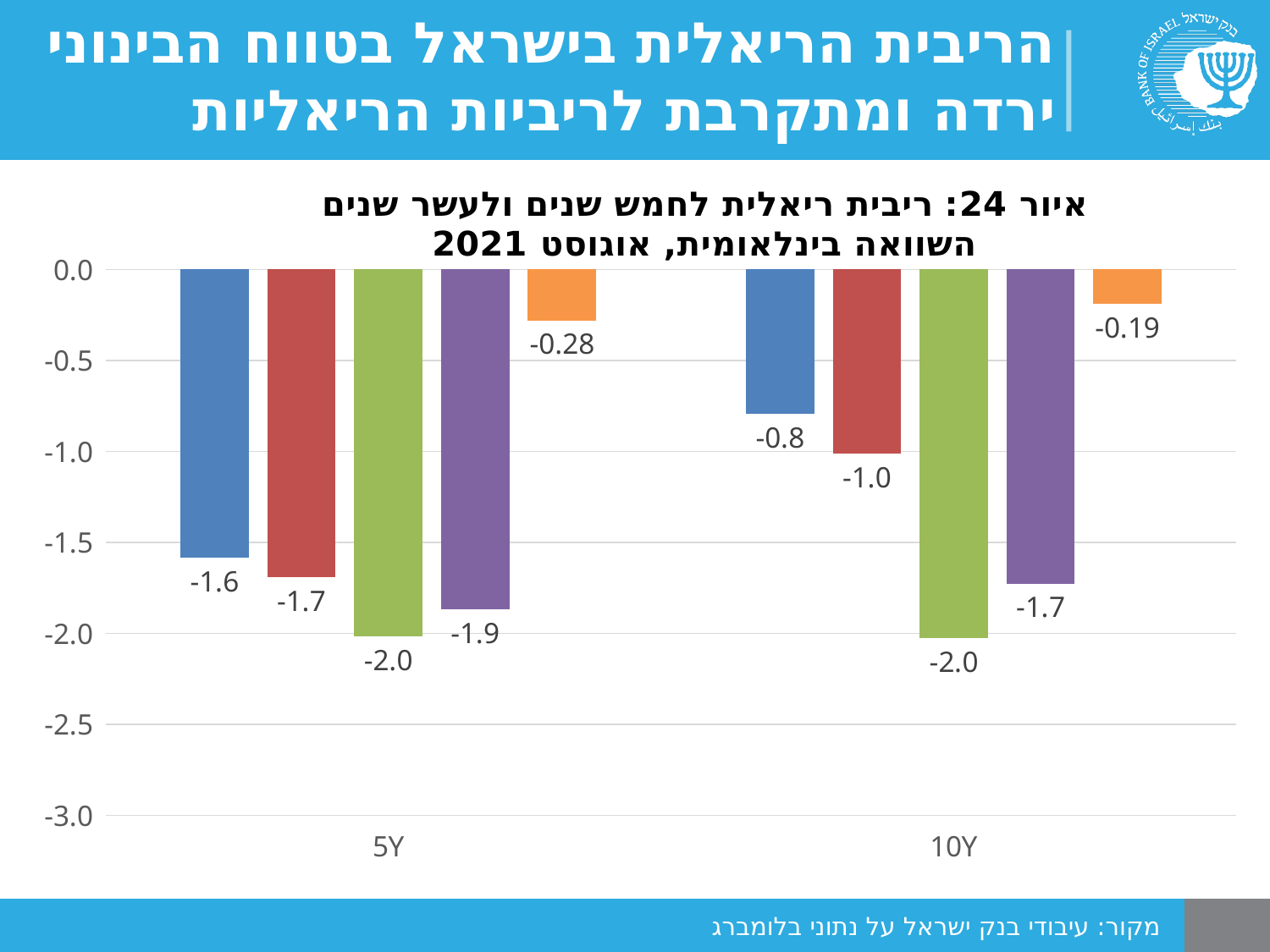
What is the difference between the blue bar in the 5Y group (-1.6) and the blue bar in the 10Y group (-0.8)? 0.8 What is the value of the orange bar in the 10Y group? -0.19 What is the value of the purple bar in the 5Y group? -1.9 What are the two category labels on the x axis? 5Y and 10Y What type of chart is shown on the slide? bar chart What is the value of the blue bar in the 10Y group? -0.8 What is the value of the green bar in the 5Y group? -2.0 How many categories are shown on the x axis? 2 How many bars are in each category group? 5 Which is larger: the red bar in the 5Y group or the red bar in the 10Y group? the red bar in the 10Y group (-1.0) What is the value of the orange bar in the 5Y group? -0.28 Which bar in the 10Y group has the lowest value? the green bar (-2.0)